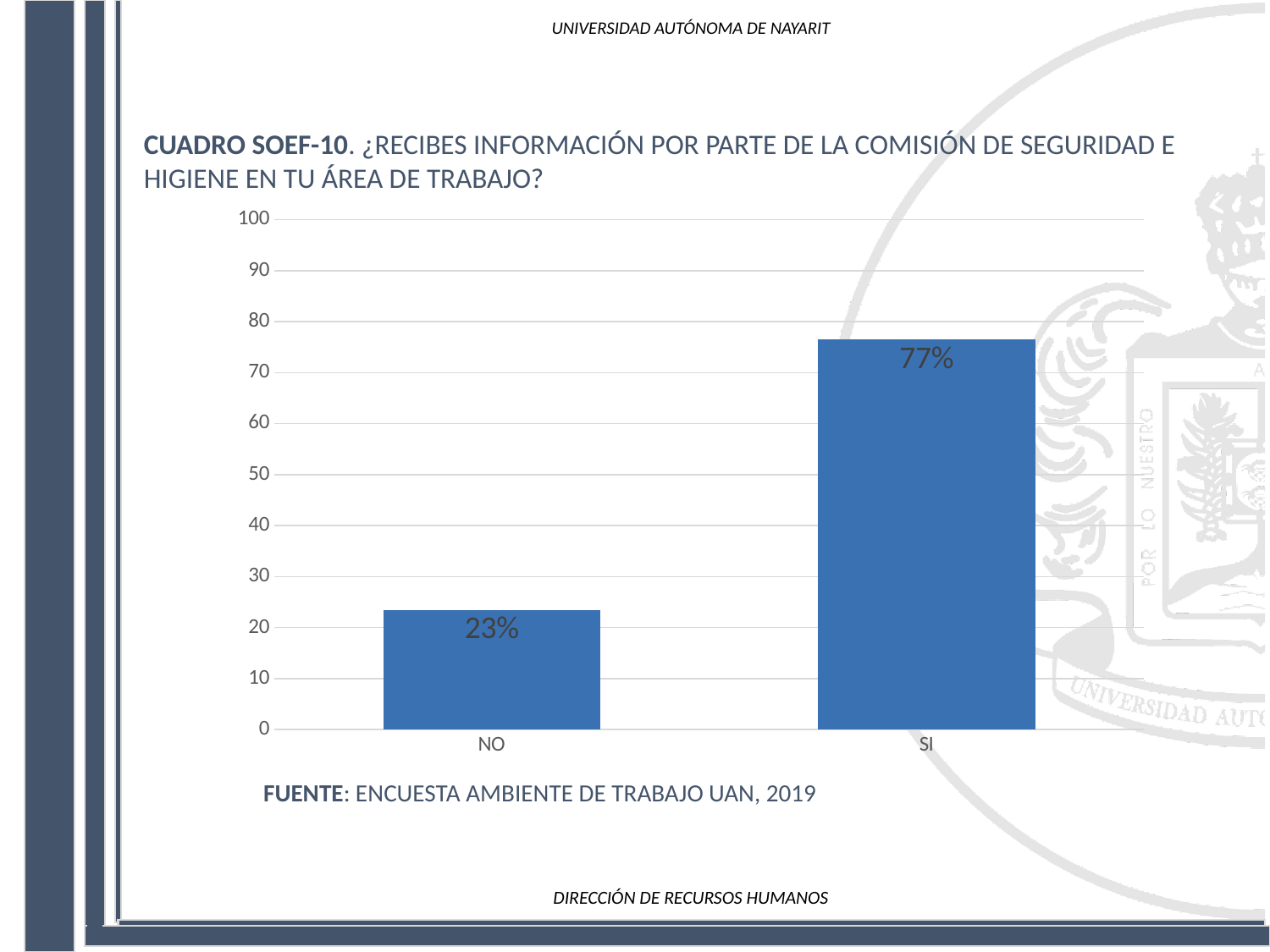
What is the value for NO? 23% How many categories are shown on the x axis? 2 What source is cited below the chart? ENCUESTA AMBIENTE DE TRABAJO UAN, 2019 Which is larger, the value for NO or the value for SI? SI Which category has the highest value? SI Is the value for SI greater or less than 70? greater Which category has the lowest value? NO What is the difference between the values for SI and NO? 54% What kind of chart is shown on the slide? bar chart What is the maximum value shown on the vertical axis? 100 What is the value for SI? 77% Is the value for NO greater or less than 30? less